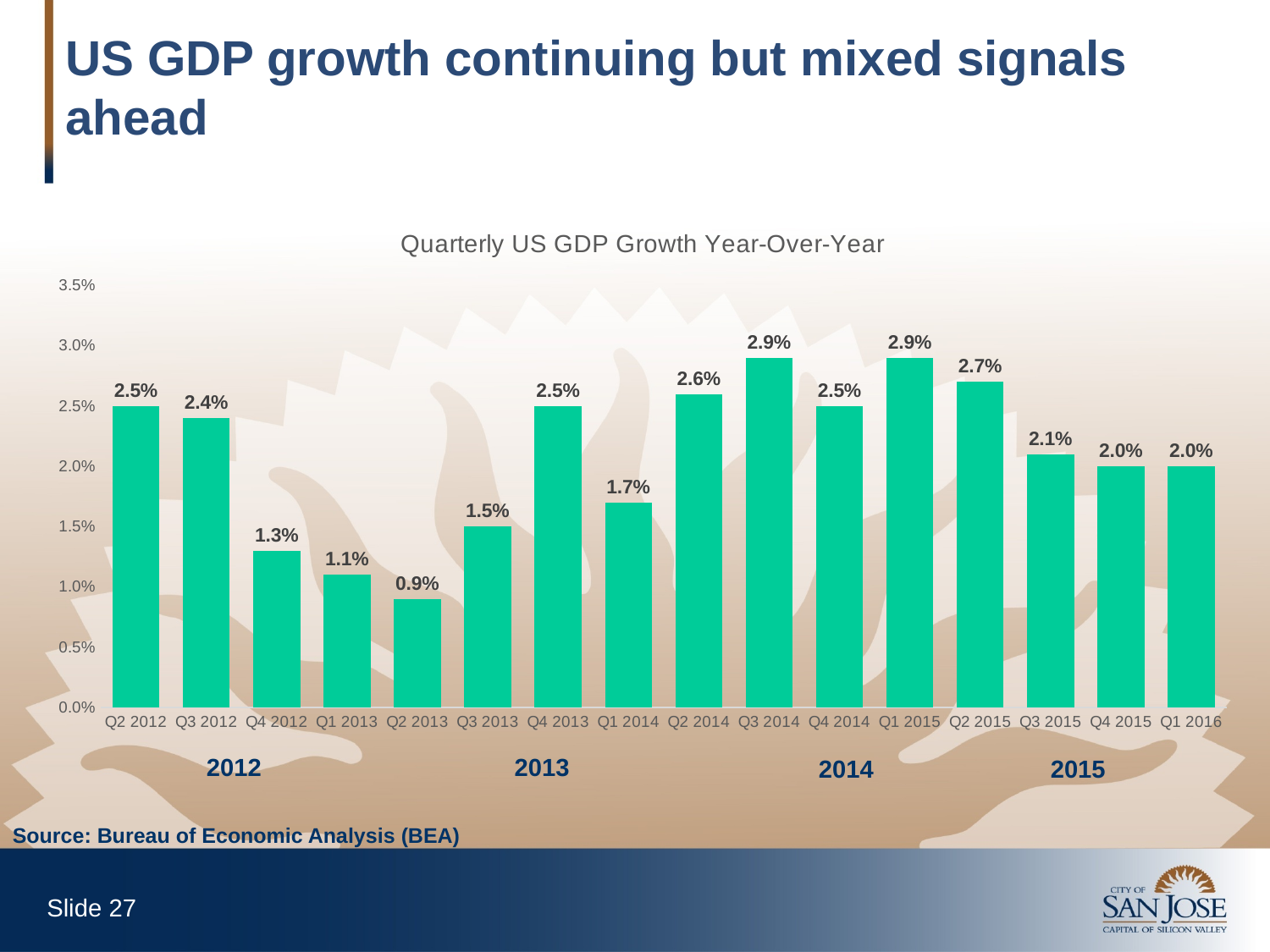
Which quarter has the lowest GDP growth? Q2 2013 What is the highest value shown on the chart? 2.9% What kind of chart is this? Bar chart What is the value for Q3 2014? 2.9% What is the value for Q2 2013? 0.9% What is the value for Q1 2016? 2.0% What is the value for Q4 2012? 1.3% Which is larger, the value for Q3 2012 or the value for Q1 2013? Q3 2012 What is the difference between the values for Q1 2014 and Q2 2014? 0.9% What is the difference between the values for Q2 2015 and Q3 2015? 0.6% What is the title of the chart? Quarterly US GDP Growth Year-Over-Year How many quarters are shown on the chart? 16